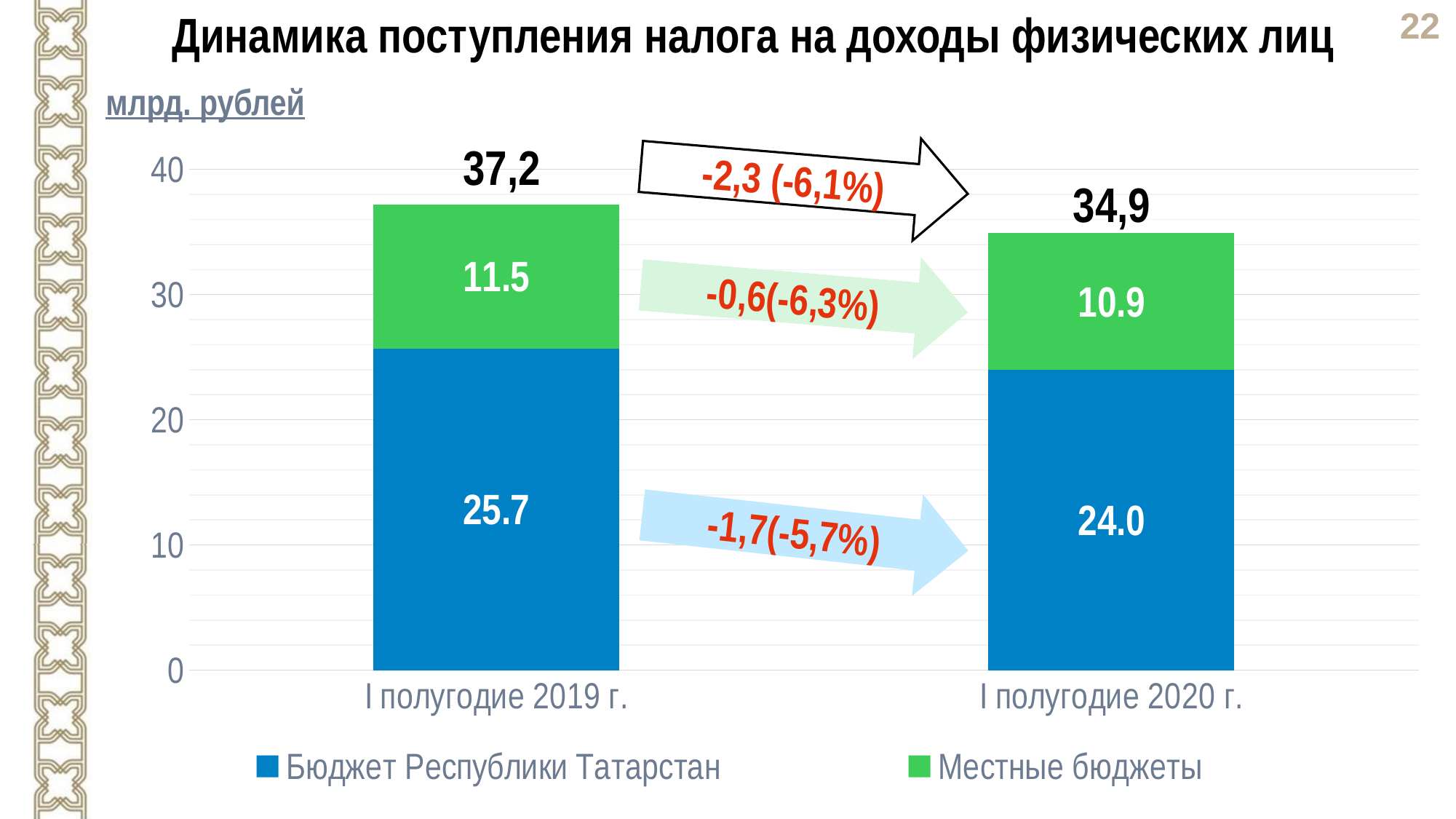
Which colour represents Местные бюджеты in the chart? Green How many series does the legend list? 2 What is the value for Местные бюджеты in I полугодие 2020 г.? 10.9 Is the total for I полугодие 2020 г. greater or less than 30? greater Which period has the higher value for Местные бюджеты, I полугодие 2019 г. or I полугодие 2020 г.? I полугодие 2019 г. What is the total of the stacked bar for I полугодие 2019 г.? 37,2 What is the value for Бюджет Республики Татарстан in I полугодие 2020 г.? 24.0 What is the difference between the Бюджет Республики Татарстан values for I полугодие 2019 г. and I полугодие 2020 г.? 1.7 What is the value for Бюджет Республики Татарстан in I полугодие 2019 г.? 25.7 What kind of chart is shown on the slide? Stacked bar chart How many categories are shown on the x axis? 2 What is the total of the stacked bar for I полугодие 2020 г.? 34,9